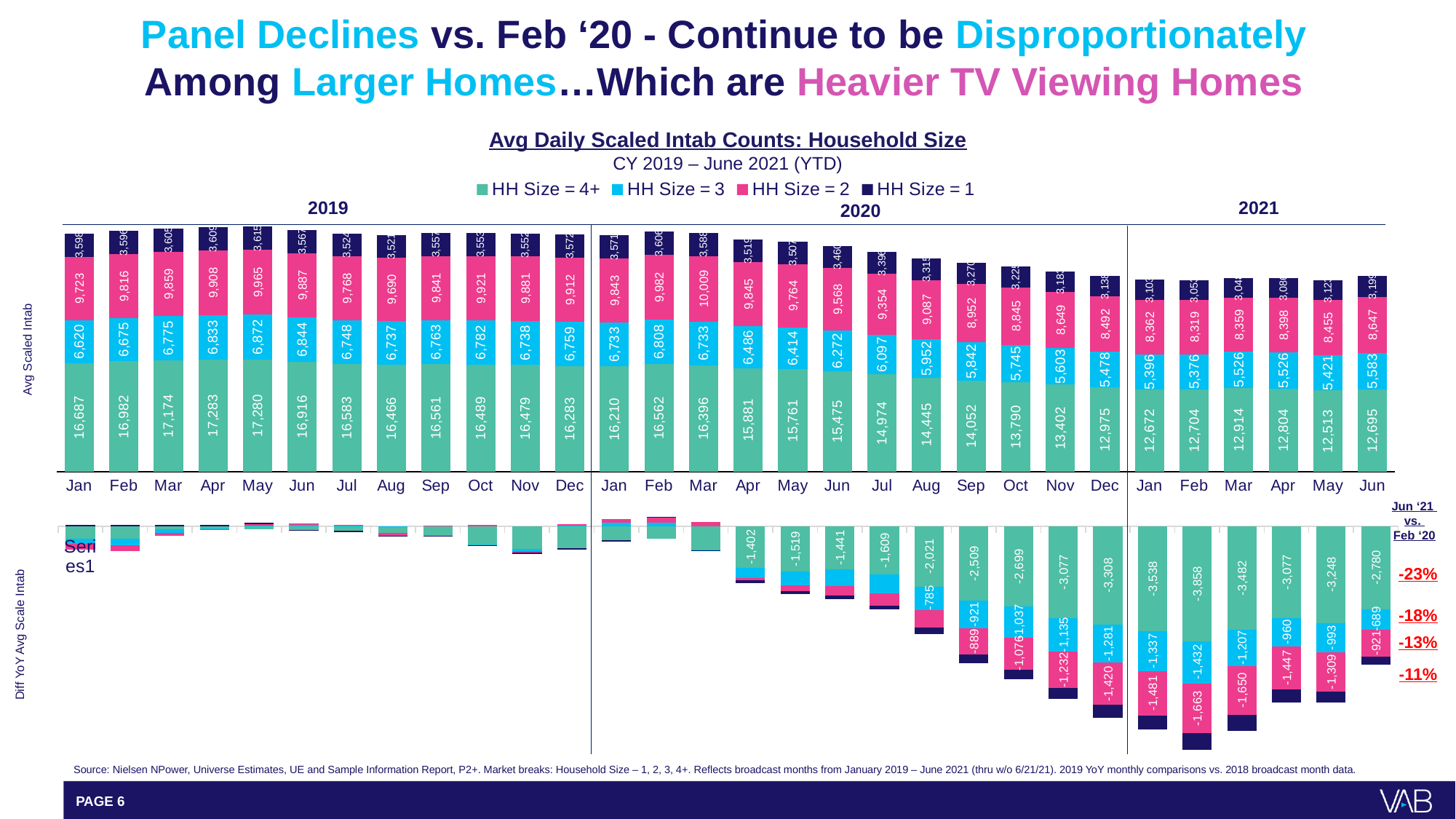
In the top chart (Avg Daily Scaled Intab Counts), what is the HH Size = 4+ value for Jan 2019? 16,687 In the top chart, what is the HH Size = 2 value for Jun 2021? 8,647 In the top chart, what is the HH Size = 4+ value for Jun 2021? 12,695 In the top chart, what is the difference between the HH Size = 4+ value for Feb 2020 and Feb 2021? 3,858 In the bottom chart, what is the Jun '21 vs. Feb '20 percentage shown for HH Size = 4+? -23% In the top chart, which month in 2020 has the highest HH Size = 2 value? Mar In the top chart, what is the HH Size = 3 value for Mar 2020? 6,733 What kind of chart is the top chart (Avg Daily Scaled Intab Counts)? Stacked bar chart In the top chart, does the HH Size = 4+ value rise or fall from Jan 2020 to Dec 2020? Fall In the bottom chart (Diff YoY Avg Scale Intab), what is the HH Size = 4+ value for Feb 2021? -3,858 How many series does the legend of the top chart list? 4 In the top chart, which is larger: the HH Size = 4+ value for Mar 2019 or for Mar 2021? Mar 2019